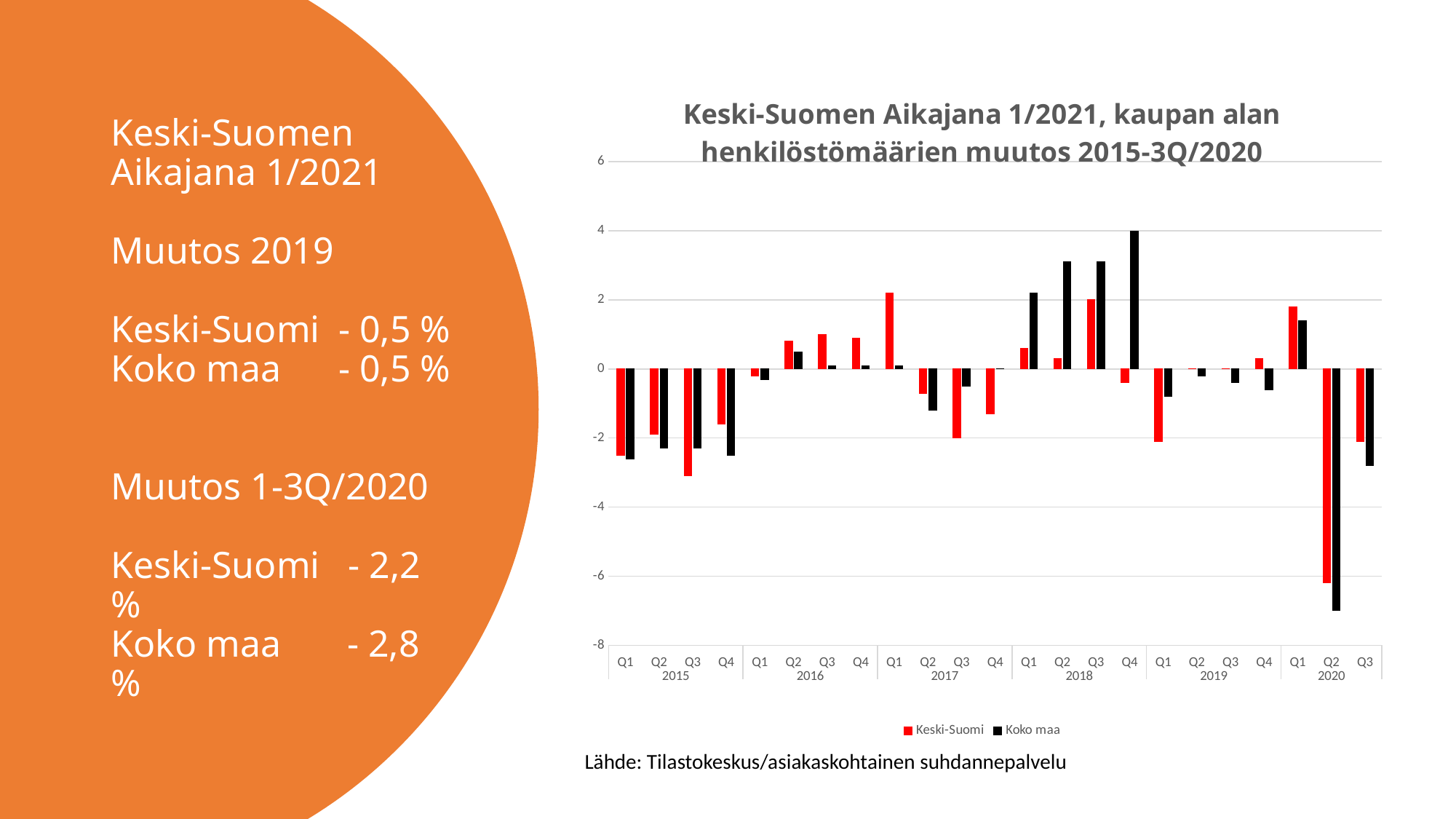
What kind of chart is shown on the slide? bar chart How many quarters are plotted on the x axis of the chart? 23 In which quarter does the Koko maa series reach its highest value? Q4 2018 How many series does the chart legend list? 2 Is the Koko maa value for Q2 2018 greater or less than 2? greater In which quarter does the Koko maa series reach its lowest value? Q2 2020 Which colour represents the Keski-Suomi series in the chart? red Is the Koko maa value for Q2 2020 greater or less than -6? less Is the Keski-Suomi value for Q3 2015 greater or less than -2? less What are the two series named in the chart legend? Keski-Suomi and Koko maa In Q3 2018, which series has the larger value, Keski-Suomi or Koko maa? Koko maa In which quarter does the Keski-Suomi series reach its lowest value? Q2 2020